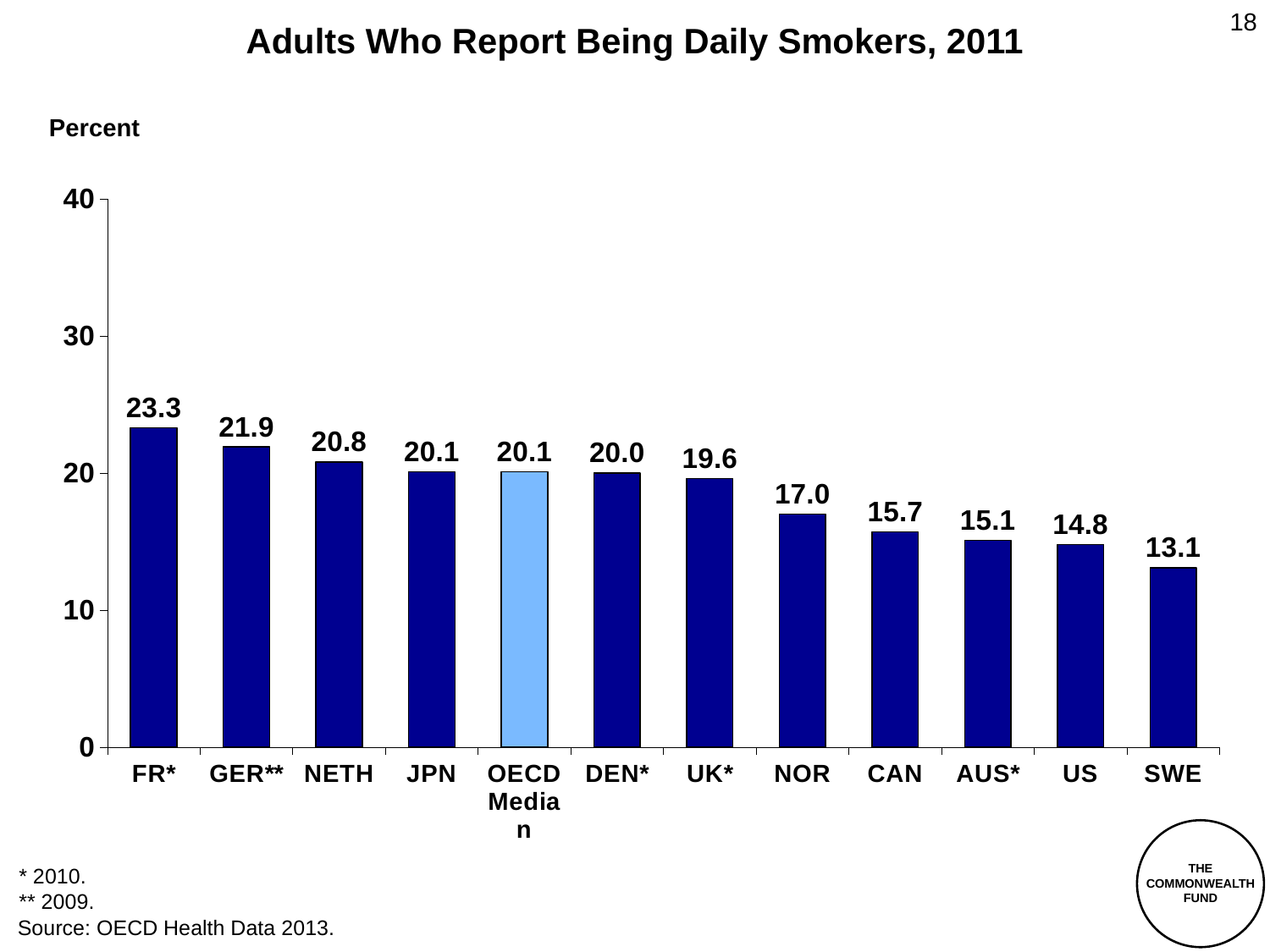
Which bar is shown in a lighter blue colour than the others? OECD Median What is the value for FR*? 23.3 Which is larger, the value for GER** or the value for NETH? GER** What is the difference between the values for NOR and CAN? 1.3 What is the difference between the values for FR* and SWE? 10.2 Which category has the lowest value? SWE What is the value for the OECD Median? 20.1 Which category has the highest value? FR* How many bars are shown in the chart? 12 Is the value for AUS* greater or less than 20? less What kind of chart is shown on the slide? bar chart What is the value for the US? 14.8